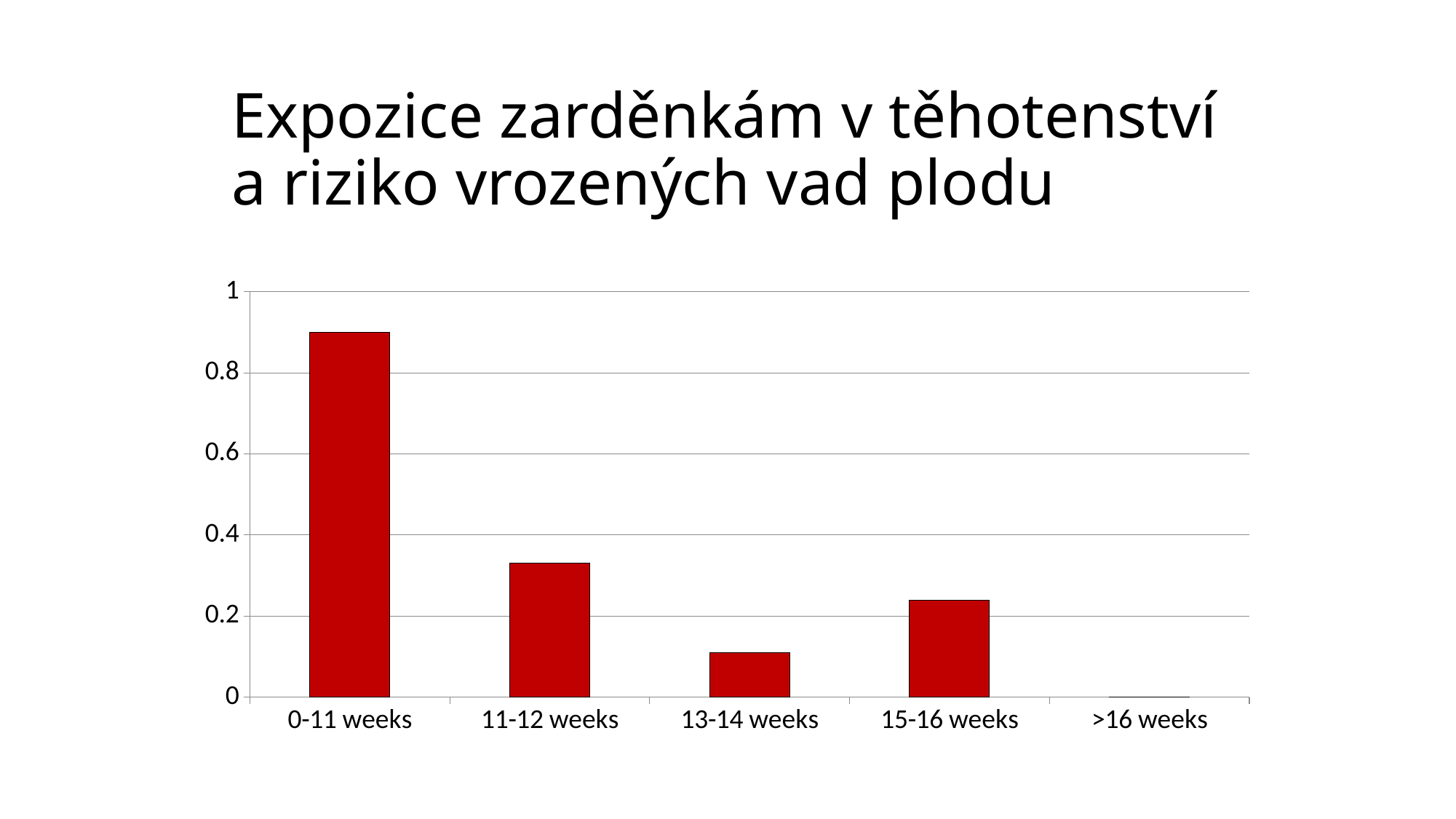
What is the title of the slide containing the chart? Expozice zarděnkám v těhotenství a riziko vrozených vad plodu Which category has the lowest bar in the chart? >16 weeks Is the value for 13-14 weeks greater or less than 0.2? less Is the value for 15-16 weeks greater or less than 0.2? greater Do the values rise or fall from 0-11 weeks to 13-14 weeks? fall Which is larger, the value for 13-14 weeks or the value for 15-16 weeks? 15-16 weeks How many categories are shown on the x axis of the chart? 5 Is the value for 11-12 weeks greater or less than 0.4? less Which is larger, the value for 11-12 weeks or the value for 15-16 weeks? 11-12 weeks What kind of chart is shown on the slide? bar chart Which category has the highest bar in the chart? 0-11 weeks